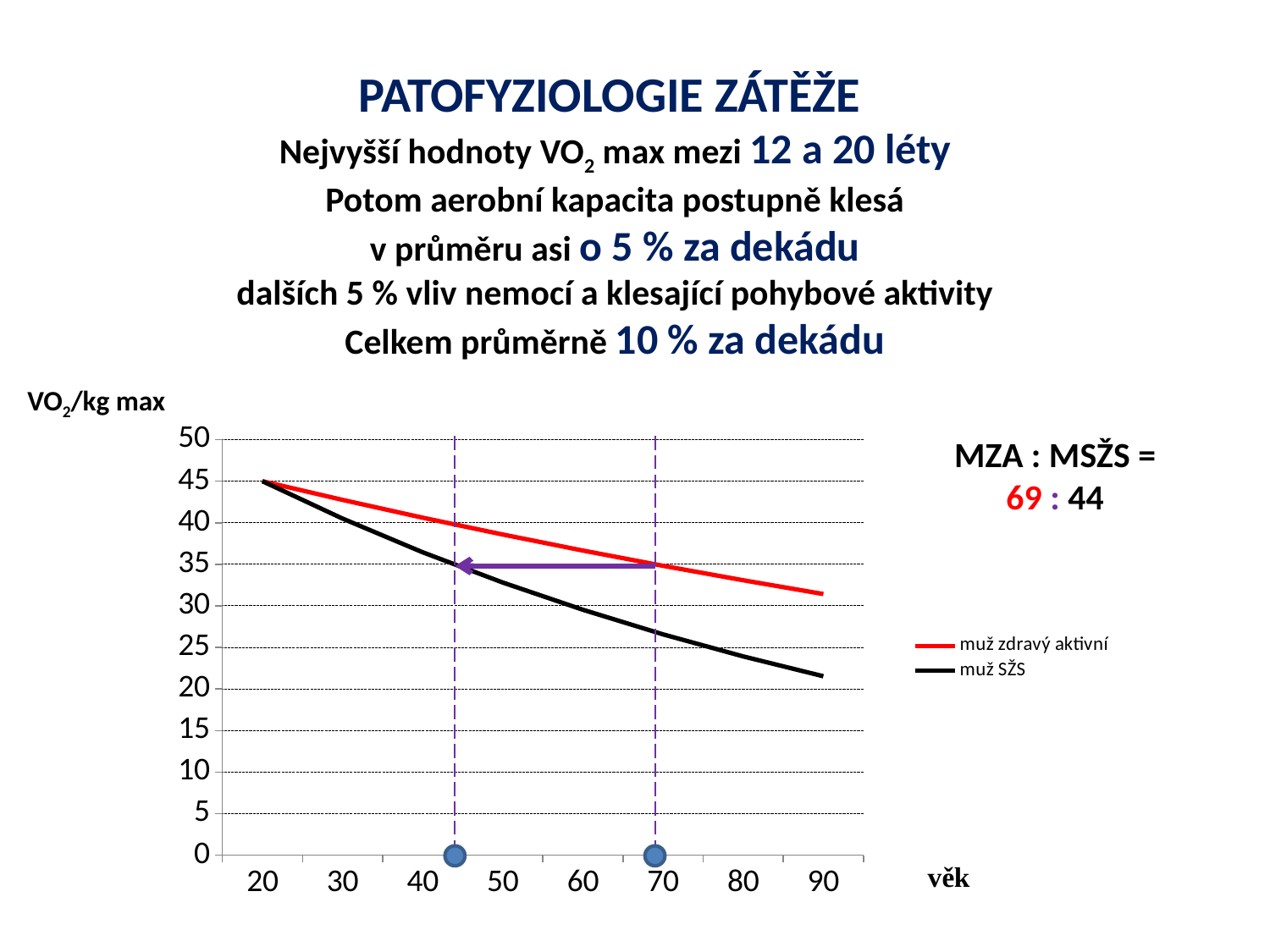
Do the values of both series rise or fall as age (věk) increases along the x axis? fall Is the value for muž SŽS at age 50 greater or less than 35? less At age 60, which series has the higher VO2/kg max value, muž zdravý aktivní or muž SŽS? muž zdravý aktivní Is the value for muž SŽS at age 70 greater or less than 30? less Is the value for muž SŽS at age 40 greater or less than 35? greater What are the two series named in the chart legend? muž zdravý aktivní and muž SŽS Which series is drawn in red in the chart? muž zdravý aktivní How many series does the chart legend list? 2 What kind of chart is shown on the slide? line chart